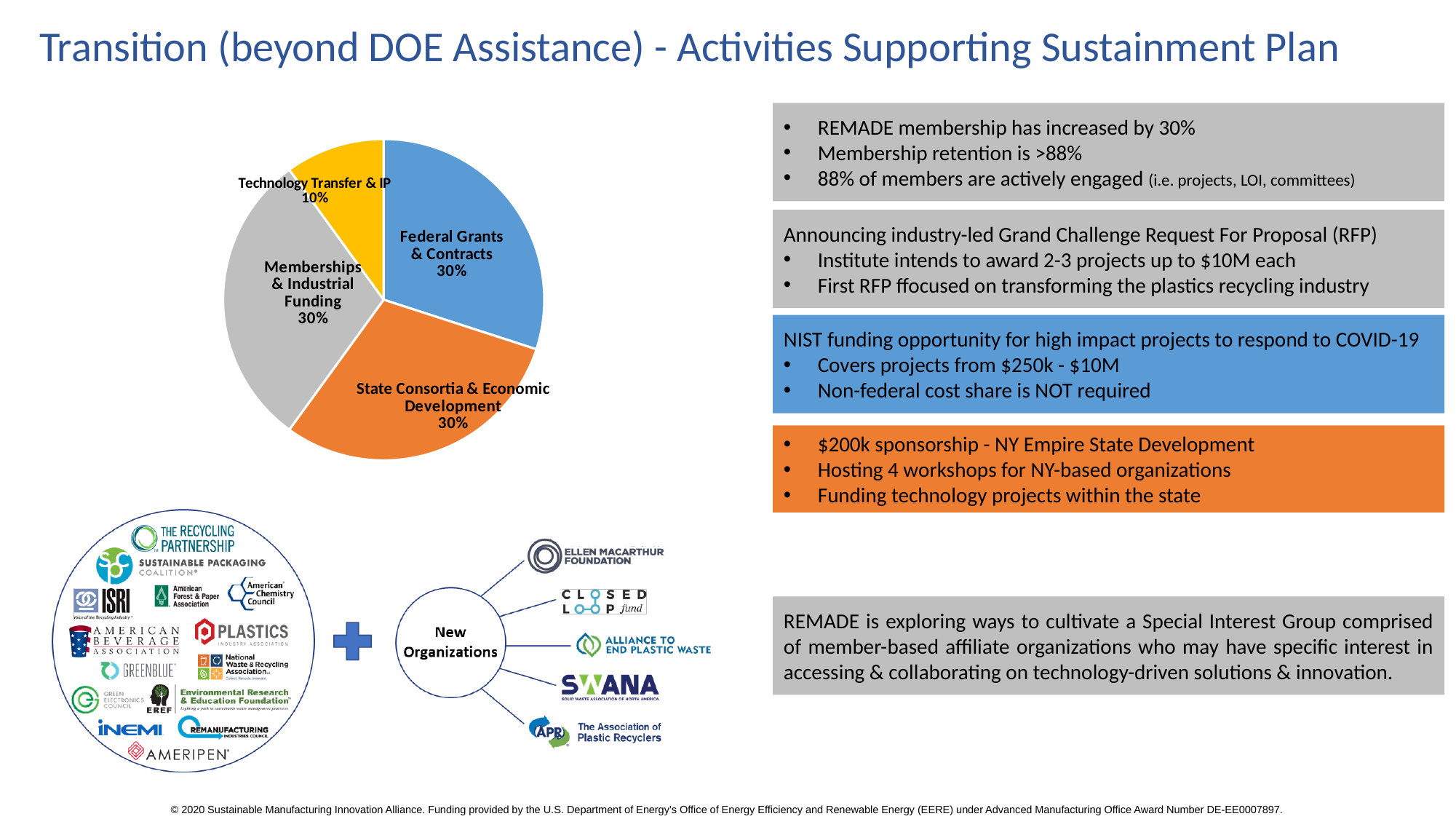
What is the difference between the Memberships & Industrial Funding share and the Technology Transfer & IP share in the pie chart? 20% Which slice of the pie chart is the smallest? Technology Transfer & IP What colour is the Technology Transfer & IP slice in the pie chart? yellow What percentage does the pie chart show for Technology Transfer & IP? 10% What share of the pie does Technology Transfer & IP represent? 10% How many slices does the pie chart have? 4 What percentage does the pie chart show for Federal Grants & Contracts? 30% What percentage does the pie chart show for State Consortia & Economic Development? 30% What kind of chart is shown on the slide? pie chart Which is larger in the pie chart: Federal Grants & Contracts or Technology Transfer & IP? Federal Grants & Contracts What percentage does the pie chart show for Memberships & Industrial Funding? 30% What colour is the Federal Grants & Contracts slice in the pie chart? blue